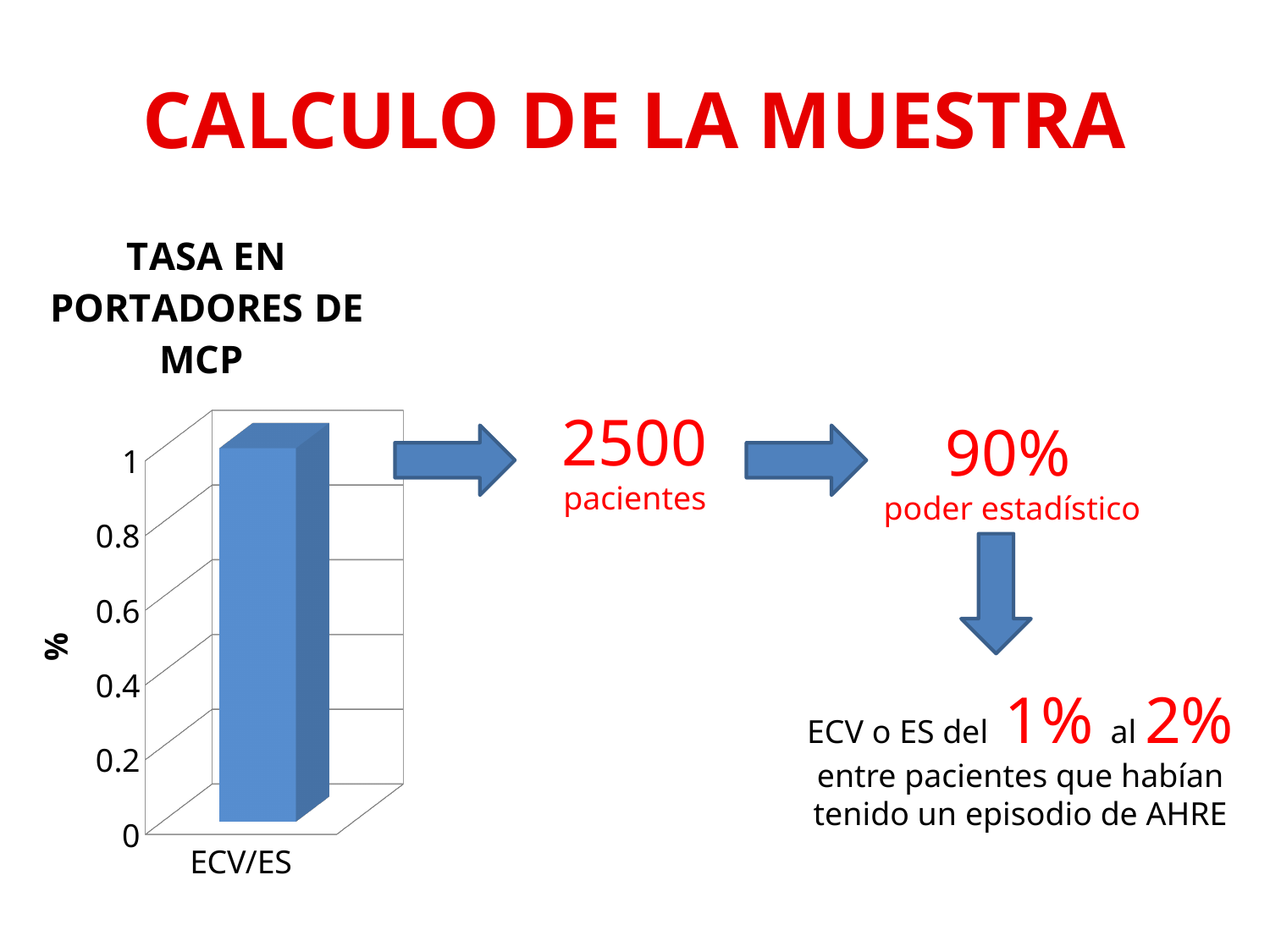
Is the value for ECV/ES greater or less than 0.4? greater What is the highest value shown on the vertical axis of the chart? 1 How many bars does the chart show? 1 What kind of chart is shown on the slide? bar chart What value does the bar for ECV/ES reach on the vertical axis? 1 What is the title of the chart? TASA EN PORTADORES DE MCP What is the label of the vertical axis of the chart? % Is the value for ECV/ES greater or less than 0.8? greater What is the category label shown on the x axis of the chart? ECV/ES